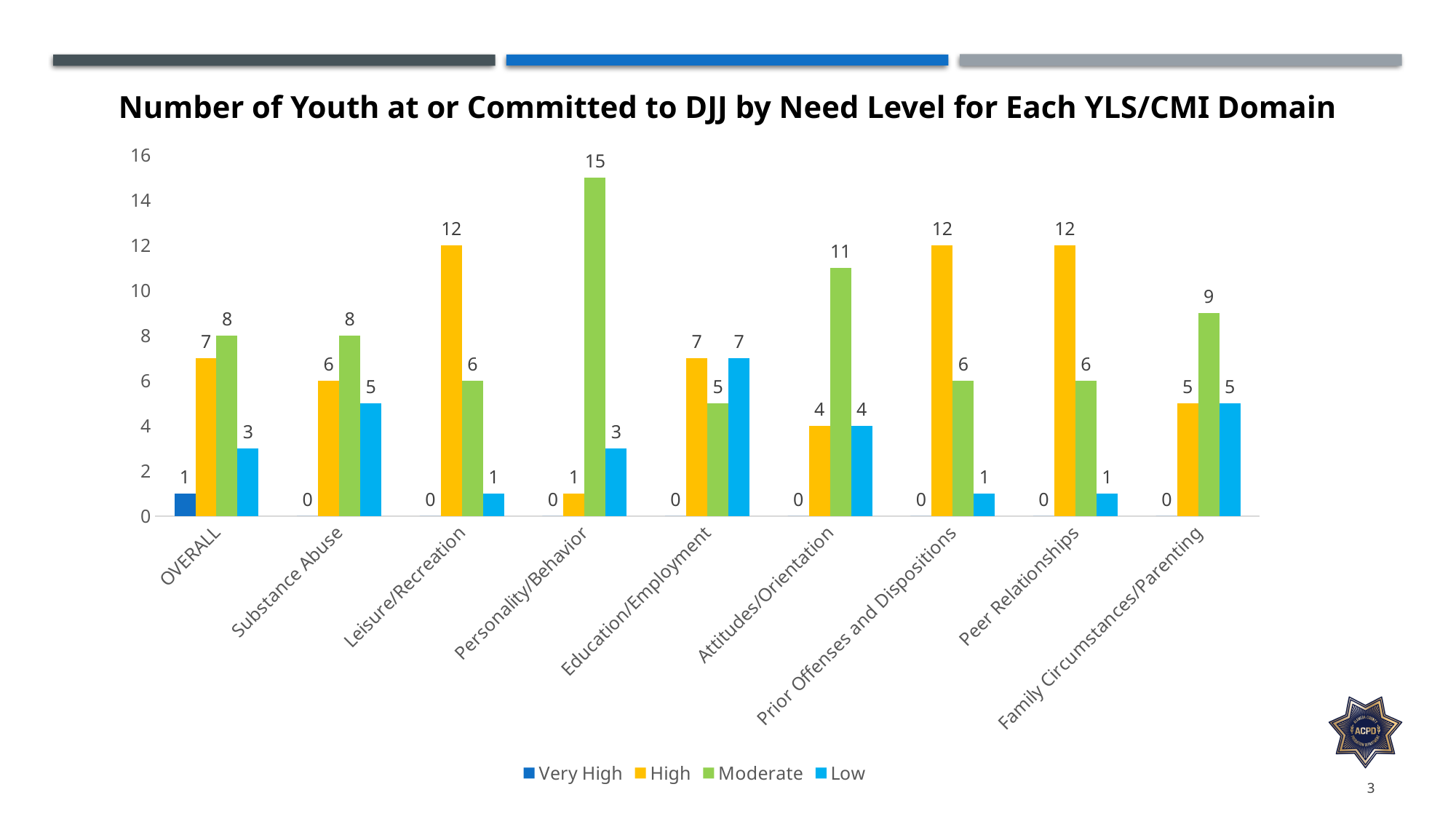
What is the title of the chart? Number of Youth at or Committed to DJJ by Need Level for Each YLS/CMI Domain What is the High value for Leisure/Recreation? 12 What is the Low value for Education/Employment? 7 What is the Moderate value for Personality/Behavior? 15 What is the Very High value for OVERALL? 1 Which category has the highest Moderate value? Personality/Behavior Which category has the lowest Low value? Leisure/Recreation, Prior Offenses and Dispositions, and Peer Relationships (all 1) Which is larger for Family Circumstances/Parenting: the Moderate value or the High value? Moderate How many series does the legend list? 4 What is the difference between the Moderate and High values for Attitudes/Orientation? 7 What kind of chart is shown on the slide? Bar chart How many categories are shown on the x axis? 9